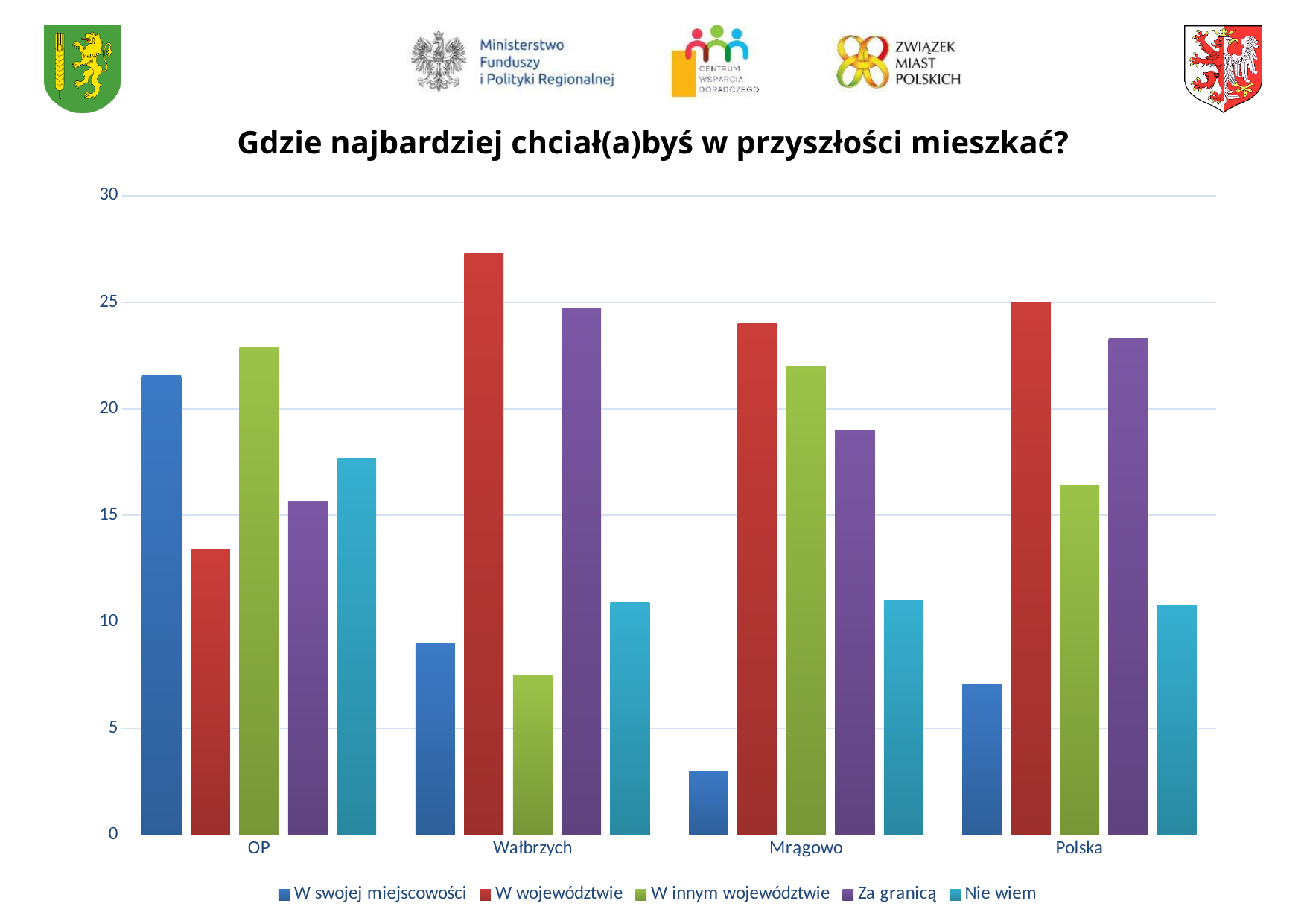
How many categories are shown on the x axis? 4 Which category has the lowest bar for 'W swojej miejscowości'? Mrągowo In OP, which is larger: 'W innym województwie' or 'W województwie'? W innym województwie What kind of chart is shown on the slide? bar chart In Mrągowo, which is larger: 'Za granicą' or 'Nie wiem'? Za granicą What is the title of the chart? Gdzie najbardziej chciał(a)byś w przyszłości mieszkać? How many series does the legend list? 5 Which series is shown in red in the legend? W województwie Which category has the highest bar for 'W województwie'? Wałbrzych Is the value for 'W swojej miejscowości' in OP greater or less than 20? greater Is the value for 'Nie wiem' in Polska greater or less than 15? less Is the value for 'Za granicą' in Wałbrzych greater or less than 20? greater